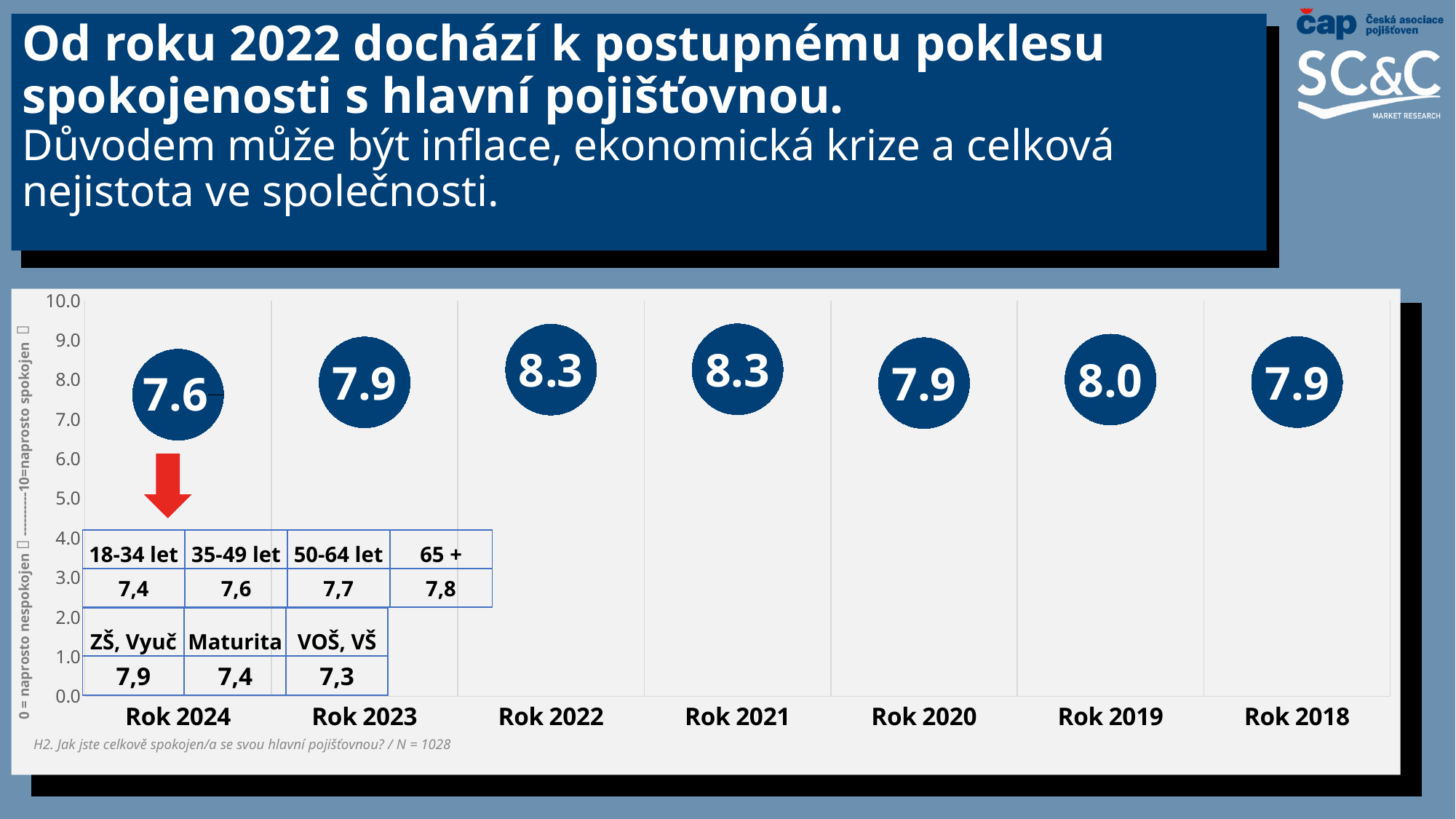
Which year has the lowest value on the chart? Rok 2024 Do the values rise or fall from Rok 2022 to Rok 2024? fall What is the satisfaction value shown for Rok 2024? 7.6 What is the value shown for Rok 2021? 8.3 Which is larger, the value for Rok 2023 or the value for Rok 2024? Rok 2023 Is the value for Rok 2020 greater or less than 5.0? greater What is the highest value shown on the chart? 8.3 How many years are shown on the x axis of the chart? 7 What is the difference between the values for Rok 2022 and Rok 2024? 0.7 In the table for Rok 2024, what is the value for the 18-34 let age group? 7,4 In the table for Rok 2024, what is the value for the VOŠ, VŠ education group? 7,3 What is the value shown for Rok 2019? 8.0